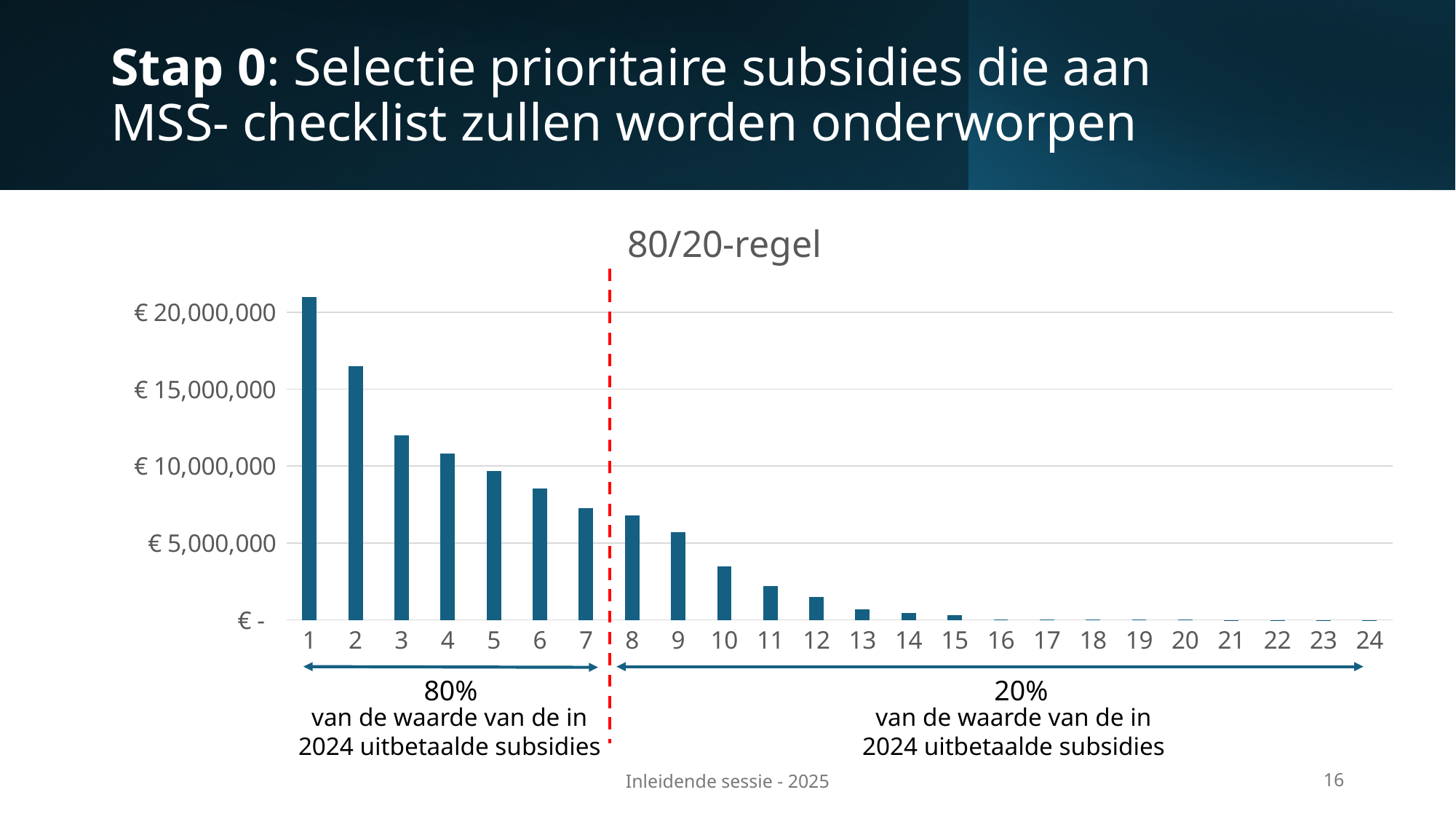
Is the value for category 2 greater or less than € 15,000,000? greater According to the labels below the chart, what share of the value of subsidies paid out in 2024 do categories 1 to 7 represent? 80% Is the value for category 9 greater or less than € 5,000,000? greater What is the title of the chart? 80/20-regel Is the value for category 5 greater or less than € 10,000,000? less Which category has the highest value in the chart? 1 How many categories are shown on the x axis of the chart? 24 Do the values rise or fall as you move from category 1 to category 24 along the x axis? fall Which has a larger value, category 3 or category 9? category 3 What kind of chart is shown on the slide? bar chart